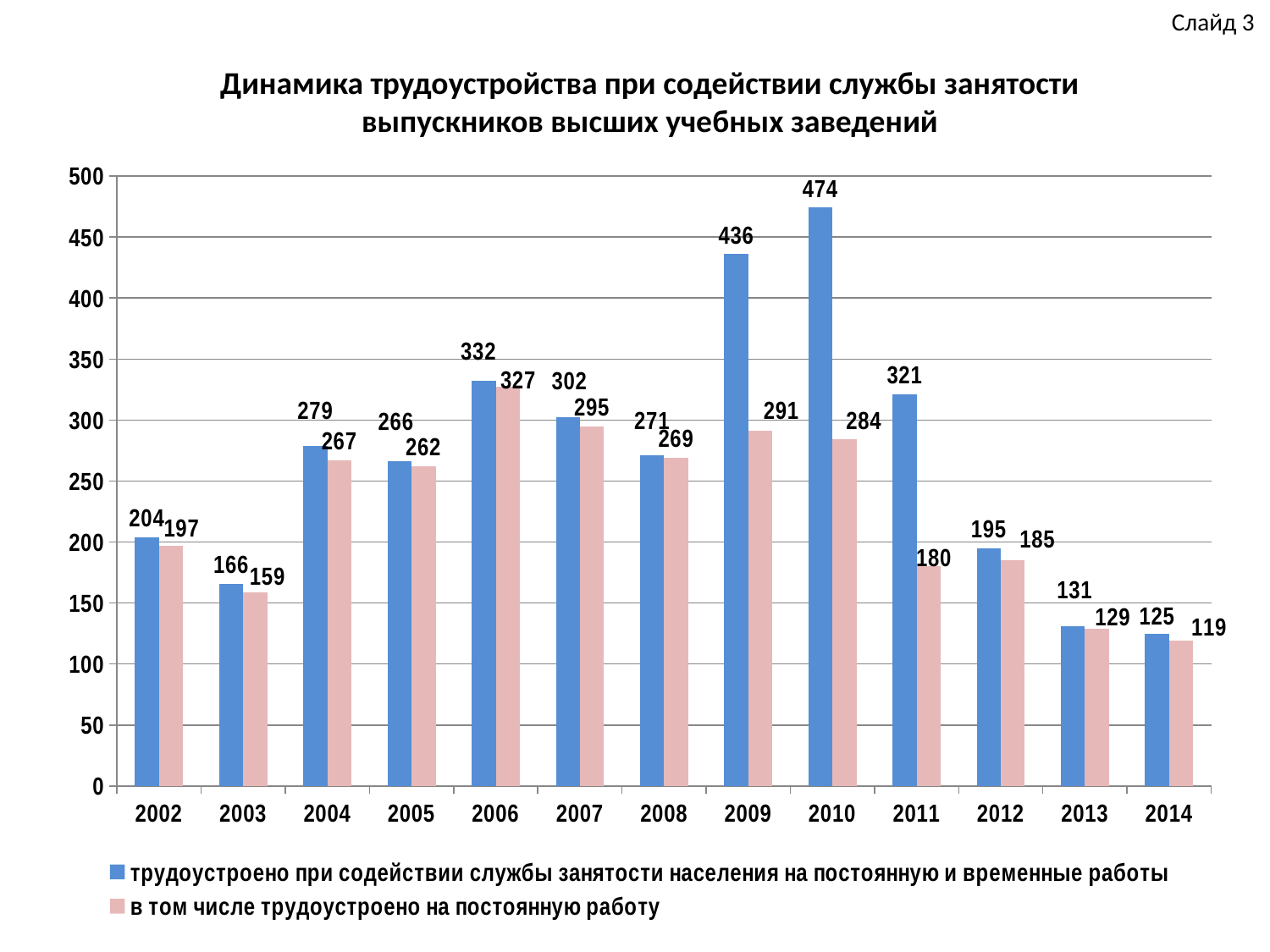
How many years are shown on the x axis? 13 Which year has the highest value for the blue series (трудоустроено при содействии службы занятости населения на постоянную и временные работы)? 2010 What is the value of the pink series (в том числе трудоустроено на постоянную работу) for 2006? 327 Is the blue series value for 2009 greater or less than 400? greater What is the difference between the blue series values for 2009 and 2010? 38 How many series does the legend list? 2 What is the value of the blue series (трудоустроено при содействии службы занятости населения на постоянную и временные работы) for 2010? 474 What kind of chart is shown on the slide? bar chart Which is larger: the blue series value for 2004 or for 2005? 2004 Do the values of the blue series rise or fall from 2011 to 2014? fall Which year has the lowest value for the pink series (в том числе трудоустроено на постоянную работу)? 2014 What is the difference between the blue and pink values for 2011? 141